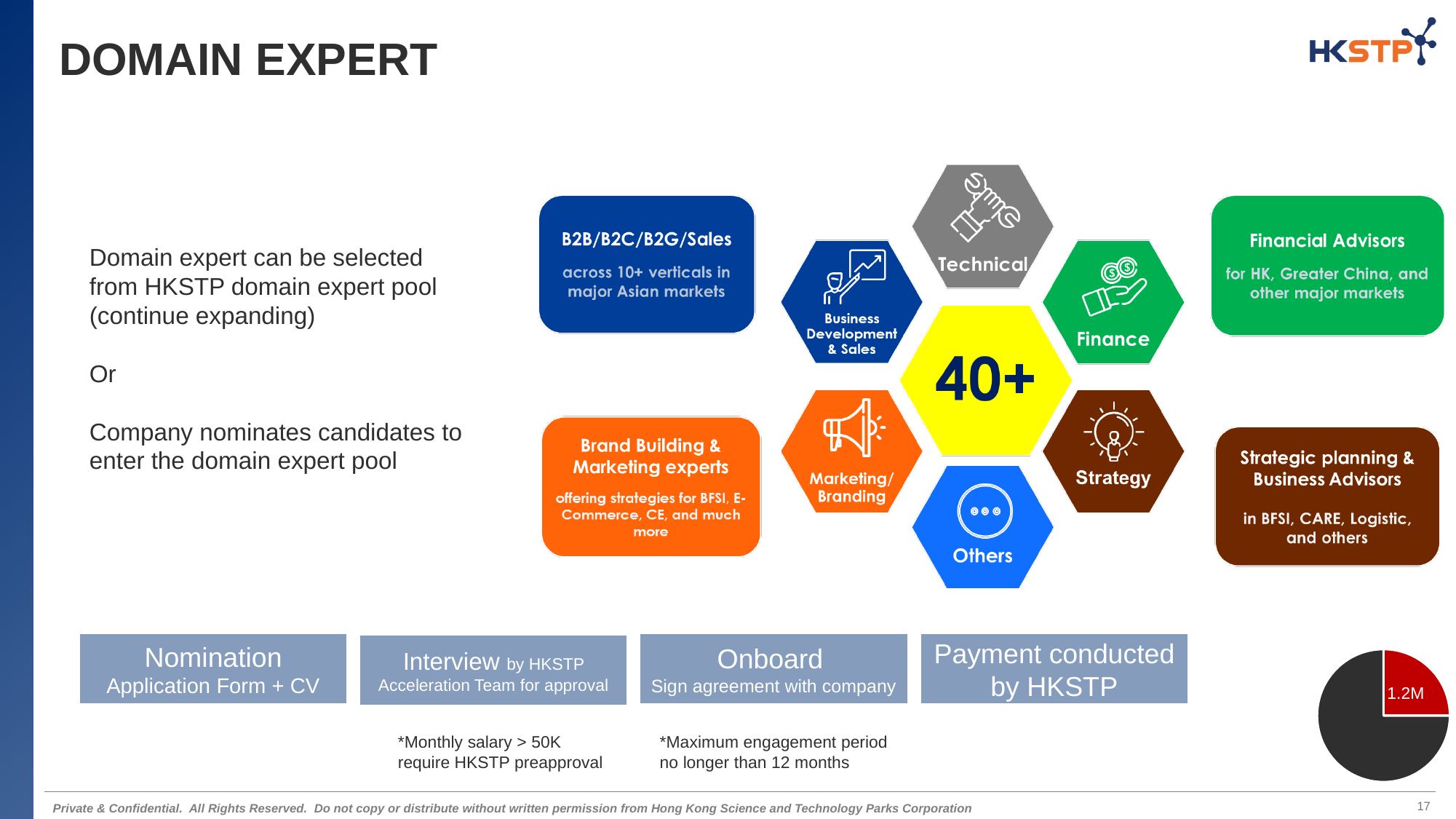
How many slices does the pie chart in the bottom-right corner have? 2 In the pie chart in the bottom-right corner, which slice is larger, the red slice or the dark grey slice? the dark grey slice What kind of chart is shown in the bottom-right corner of the slide? pie chart What value is printed on the red slice of the pie chart in the bottom-right corner? 1.2M In the pie chart in the bottom-right corner, what colour is the slice labelled 1.2M? red Does the pie chart in the bottom-right corner have a legend? No